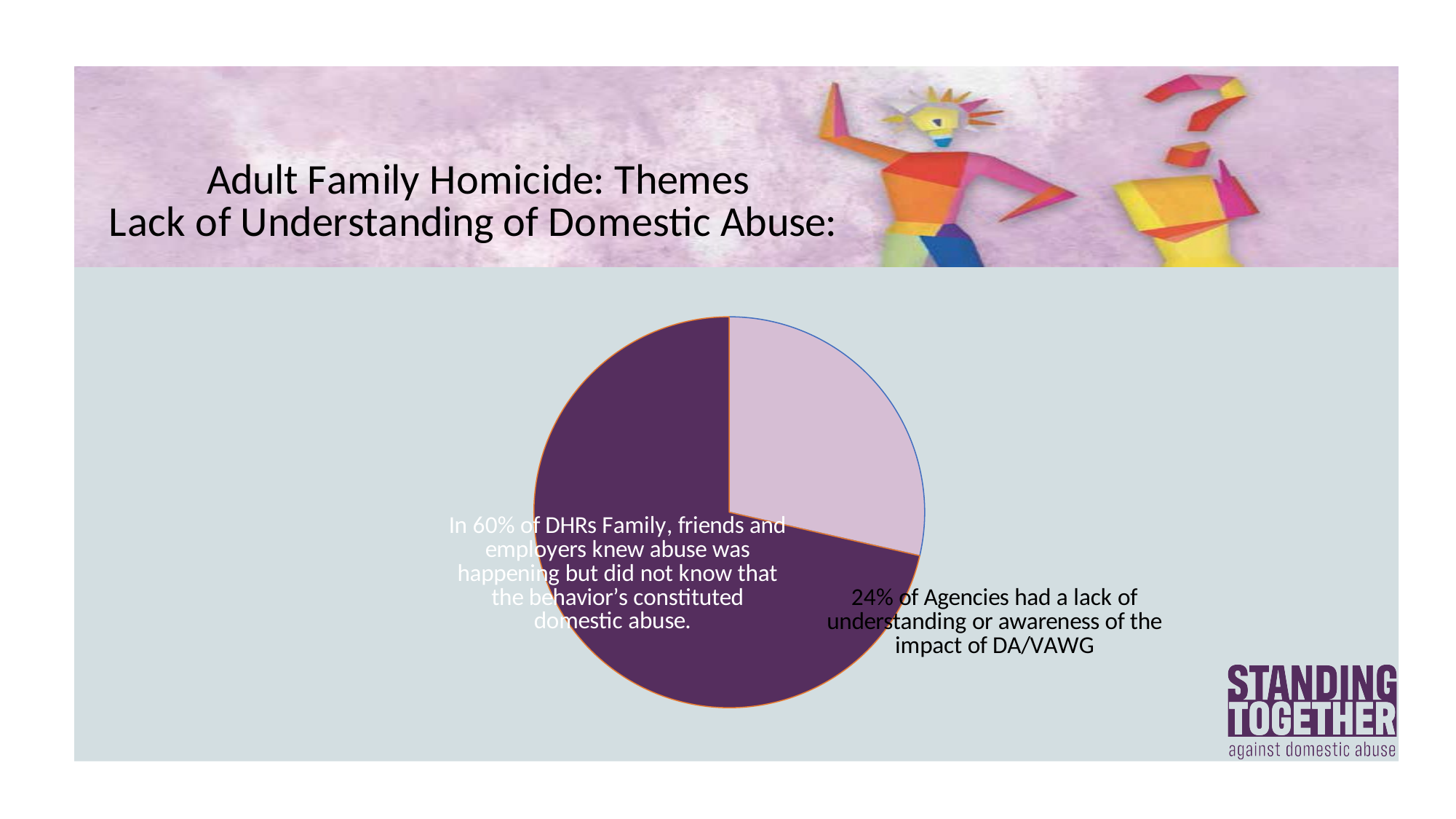
Which labelled slice of the pie is larger: the DHRs where family, friends and employers knew abuse was happening, or the agencies with a lack of understanding of DA/VAWG? DHRs where family, friends and employers knew abuse was happening (60%) What kind of chart is shown on the slide? Pie chart What percentage of agencies had a lack of understanding or awareness of the impact of DA/VAWG? 24% How many slices does the pie chart have? 2 Which of the labelled slices represents the largest share of the pie? In 60% of DHRs family, friends and employers knew abuse was happening but did not know the behaviour constituted domestic abuse In what percentage of DHRs did family, friends and employers know abuse was happening but not know that the behaviour constituted domestic abuse? 60% What colour is the slice labelled with the 60% DHRs statement? Dark purple What is the difference in percentage points between the 60% DHRs slice and the 24% agencies slice? 36 percentage points What is the title shown on the slide above the pie chart? Adult Family Homicide: Themes Lack of Understanding of Domestic Abuse: